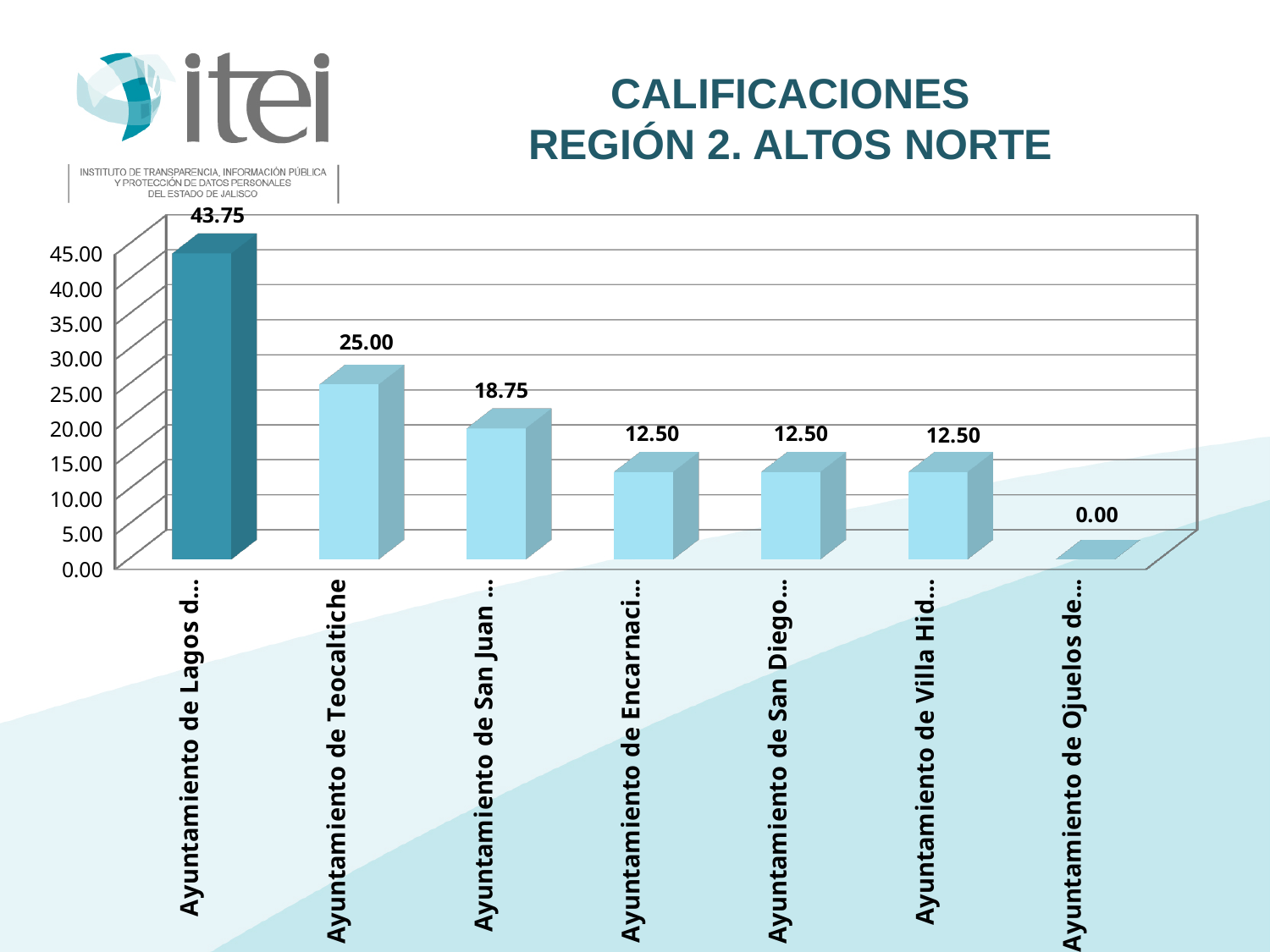
What value is shown for Ayuntamiento de Teocaltiche? 25.00 How many categories (bars) are shown in the chart? 7 Which is larger: the value for Ayuntamiento de Teocaltiche or the value for "Ayuntamiento de San Juan …"? Ayuntamiento de Teocaltiche What value is shown for the first bar, labelled "Ayuntamiento de Lagos d…"? 43.75 What value is shown for the bar labelled "Ayuntamiento de San Juan …"? 18.75 What is the difference between the value for "Ayuntamiento de Lagos d…" and the value for Ayuntamiento de Teocaltiche? 18.75 Do the values rise or fall from left to right across the chart? Fall Which category has the lowest value in the chart? Ayuntamiento de Ojuelos de… What is the title of the slide containing the chart? CALIFICACIONES REGIÓN 2. ALTOS NORTE What value is shown for the last bar, labelled "Ayuntamiento de Ojuelos de…"? 0.00 What kind of chart is shown on the slide? Bar chart Which category has the highest value in the chart? Ayuntamiento de Lagos d…